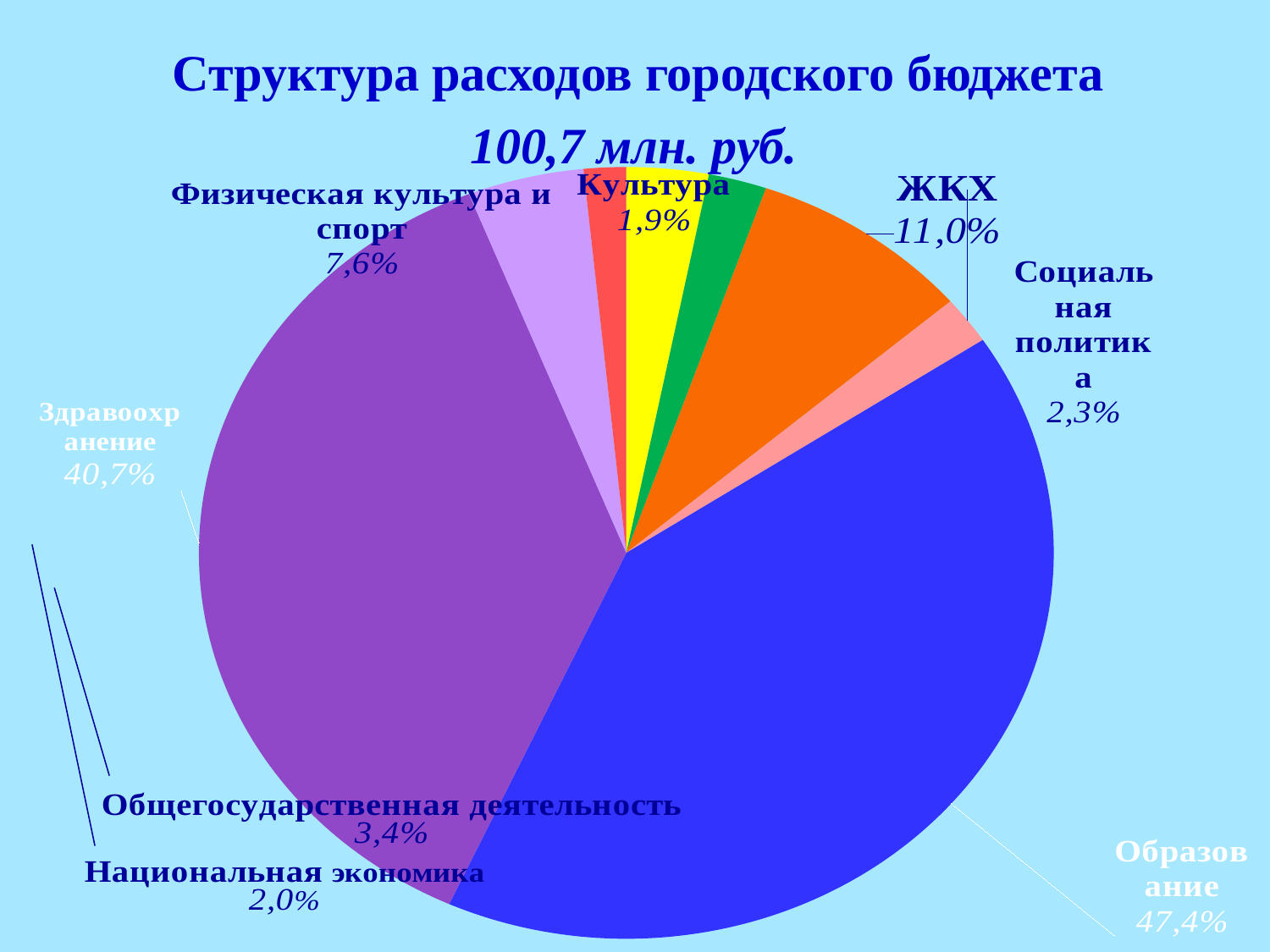
What share of the budget expenditure goes to Образование? 47,4% Which has a larger share, ЖКХ or Физическая культура и спорт? ЖКХ What share is shown for Физическая культура и спорт? 7,6% What kind of chart is shown on the slide? pie chart How many categories are labelled on the pie chart? 8 What share is shown for ЖКХ? 11,0% What is the title of the chart? Структура расходов городского бюджета 100,7 млн. руб. What is the difference between the shares of Образование and Здравоохранение? 6,7% What share of the budget expenditure goes to Здравоохранение? 40,7% Which category has the largest share of the budget? Образование What share is shown for Социальная политика? 2,3% Which category has the smallest share of the budget? Культура